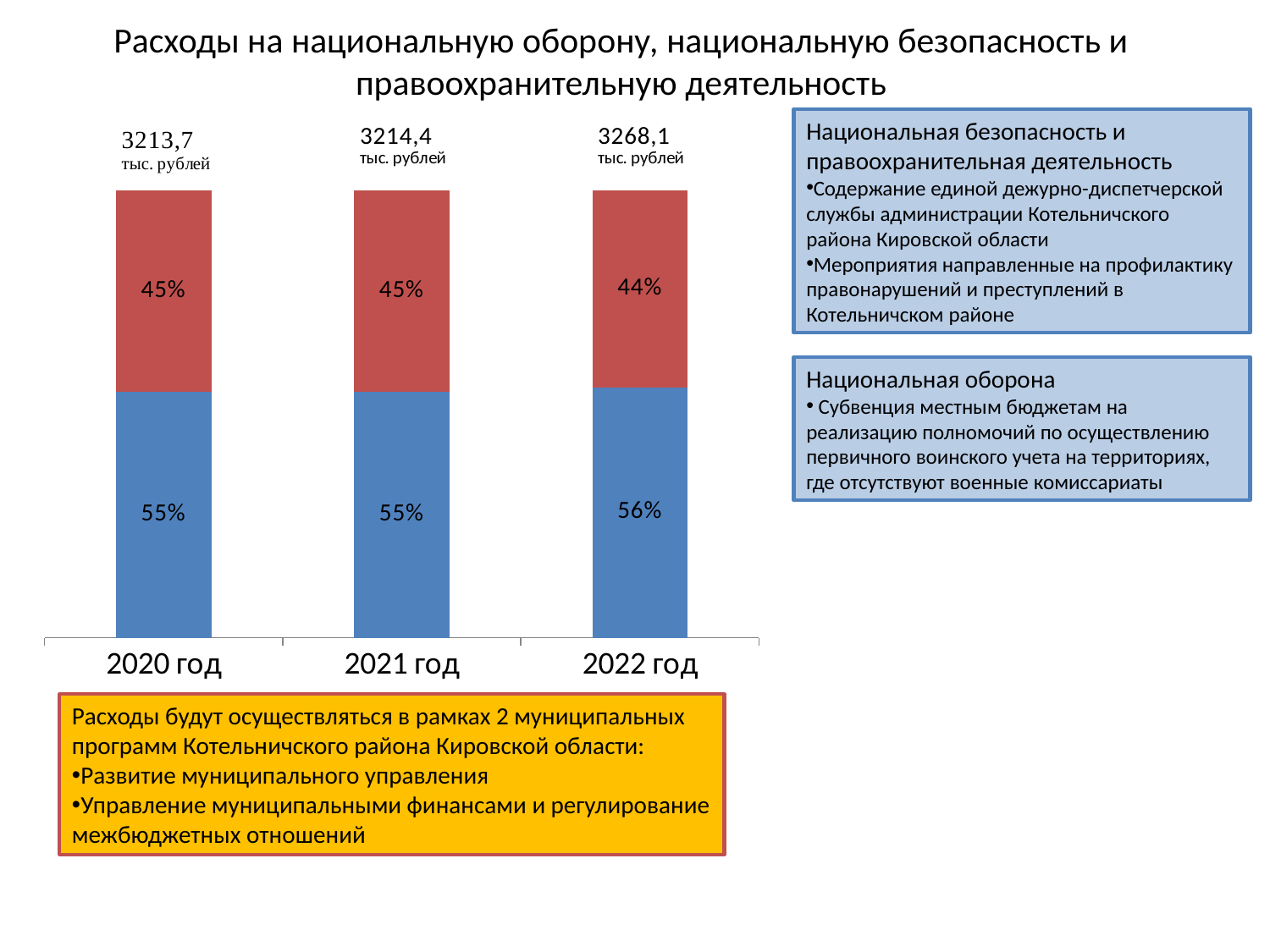
What percentage is shown on the blue segment of the bar for 2020 год? 55% How many years (categories) are shown on the x axis of the chart? 3 Which year has the lowest total value printed above its bar? 2020 год Which year has the highest total value printed above its bar? 2022 год What kind of chart is shown on the slide? bar chart What total value is printed above the bar for 2021 год? 3214,4 тыс. рублей Does the percentage on the red segment rise or fall from 2020 год to 2022 год? fall What is the sum of the two percentages shown in the bar for 2022 год? 100% What percentage is shown on the red segment of the bar for 2022 год? 44% What is the title of the chart on the slide? Расходы на национальную оборону, национальную безопасность и правоохранительную деятельность What is the difference between the total values printed for 2022 год and 2020 год? 54,4 тыс. рублей In the bar for 2021 год, which segment is larger, the blue one or the red one? the blue one